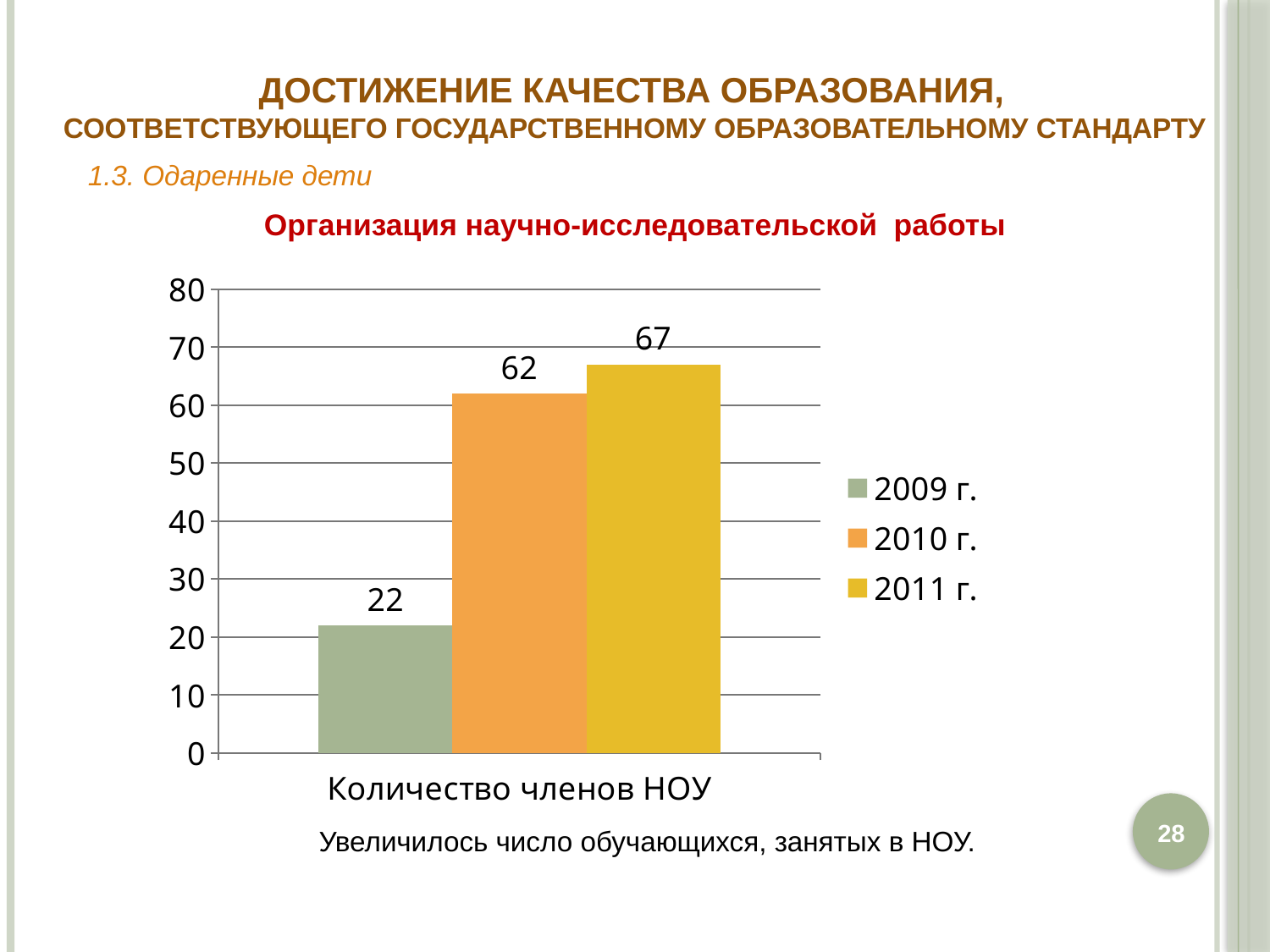
What is the difference between the values for 2010 г. and 2009 г.? 40 Which year has the lowest value in the chart? 2009 г. Which year has the highest value in the chart? 2011 г. How many series does the legend list? 3 Is the value for 2011 г. greater or less than 60? greater Which is larger, the value for 2009 г. or the value for 2010 г.? 2010 г. What kind of chart is shown on the slide? bar chart What is the difference between the values for 2011 г. and 2010 г.? 5 What is the category label shown on the x axis of the chart? Количество членов НОУ What is the value for 2010 г. in the chart? 62 What is the value for 2009 г. in the chart? 22 What is the value for 2011 г. in the chart? 67